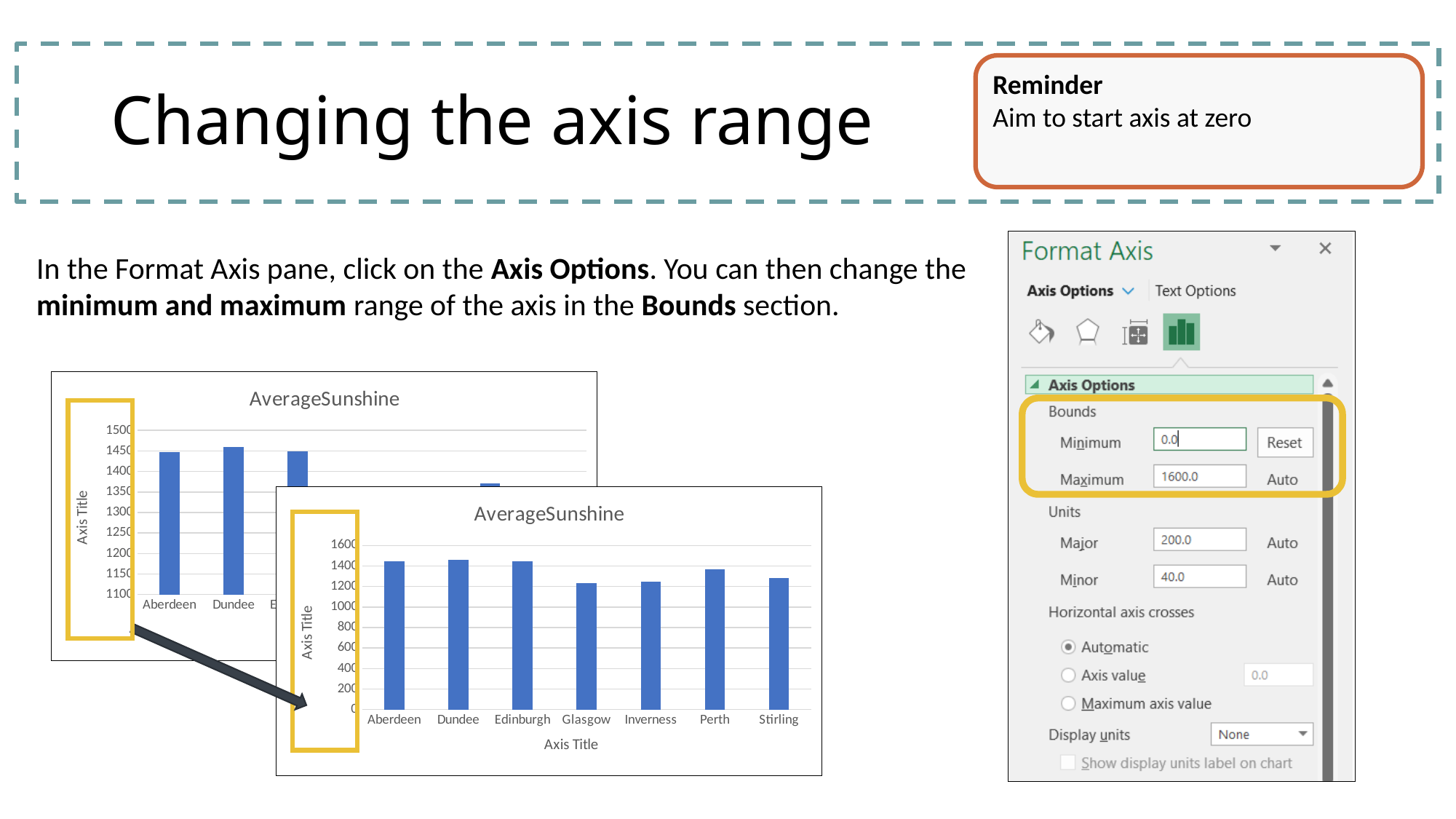
In the front AverageSunshine chart, which is larger, the value for Perth or the value for Glasgow? Perth In the front AverageSunshine chart, is the value for Glasgow greater or less than 1400? less What kind of chart is the front chart titled AverageSunshine? bar chart In the front AverageSunshine chart, is the value for Dundee greater or less than 1400? greater In the back (partially hidden) AverageSunshine chart, is the value for Aberdeen greater or less than 1400? greater What is the lowest value shown on the vertical axis of the back (partially hidden) chart? 1100 In the front AverageSunshine chart, which is larger, the value for Aberdeen or the value for Stirling? Aberdeen What is the title of the front chart? AverageSunshine In the front AverageSunshine chart, how many cities are shown on the x axis? 7